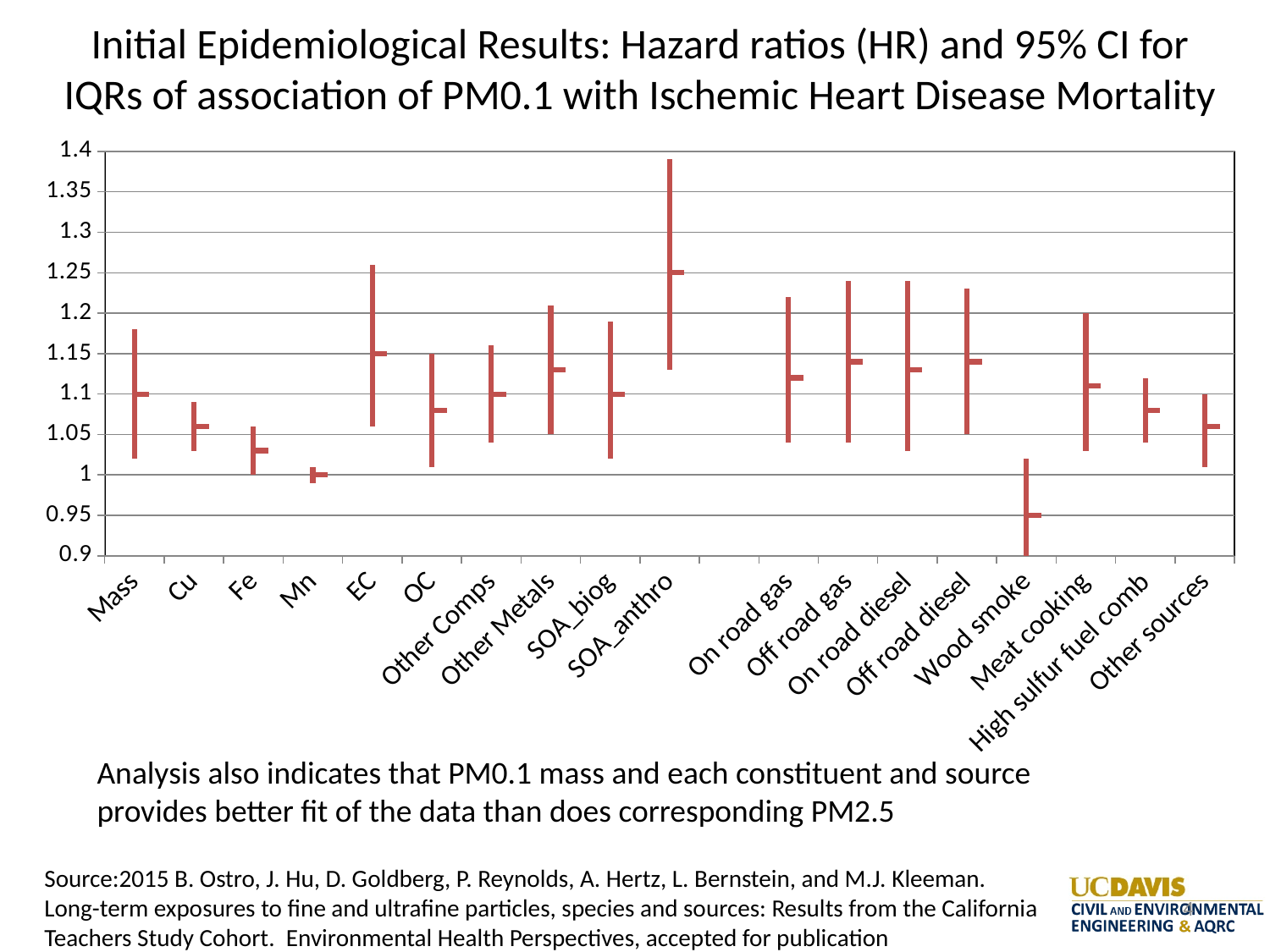
What kind of chart is shown on the slide? stock (high-low-close) chart Which category has the highest hazard ratio? SOA_anthro Which has the larger hazard ratio, Wood smoke or Meat cooking? Meat cooking What is the lowest value shown on the y axis? 0.9 What is the hazard ratio for Wood smoke? 0.95 Is the hazard ratio for Cu greater or less than 1.1? less Is the hazard ratio for Off road gas greater or less than 1.1? greater How many labeled categories are shown on the x axis? 18 Which category has the lowest hazard ratio? Wood smoke What is the hazard ratio for Mass? 1.1 What is the hazard ratio for SOA_anthro? 1.25 What is the title of the chart? Initial Epidemiological Results: Hazard ratios (HR) and 95% CI for IQRs of association of PM0.1 with Ischemic Heart Disease Mortality